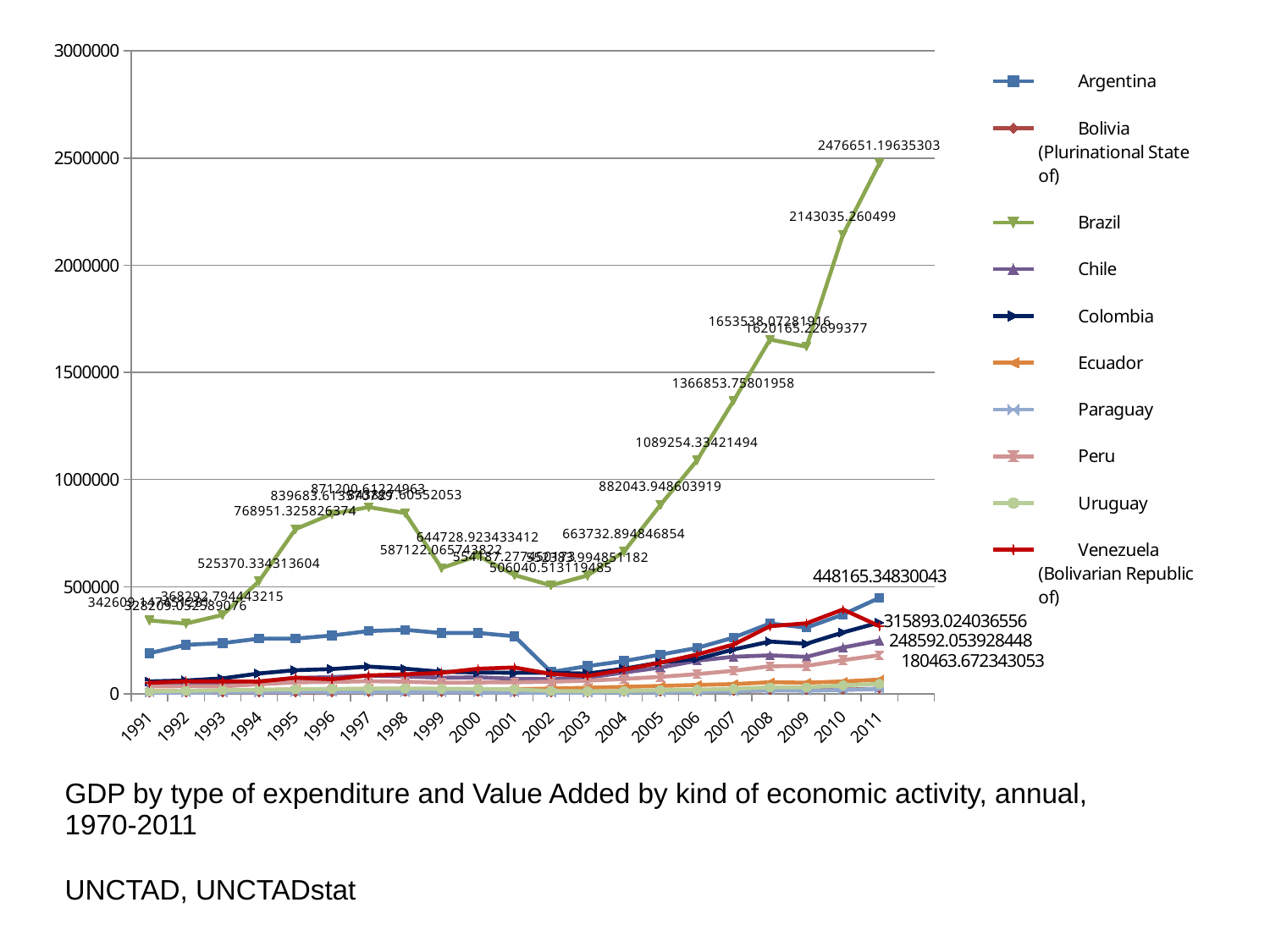
How many series does the legend list? 10 Which country has the highest value in 2011? Brazil By how much did Brazil's value increase from 2010 to 2011? 333615.93585403 What is the value for Brazil in 2007? 1366853.75801958 What kind of chart is shown on the slide? line chart Does Brazil's value rise or fall from 2002 to 2011? rise How many years are shown along the x axis? 21 Is the value for Argentina in 2011 greater or less than 500000? less Which is larger for Brazil, the 2008 value or the 2009 value? 2008 What is the value for Brazil in 2010? 2143035.260499 What is the value for Argentina in 2011? 448165.34830043 What is the value for Brazil in 2011? 2476651.19635303